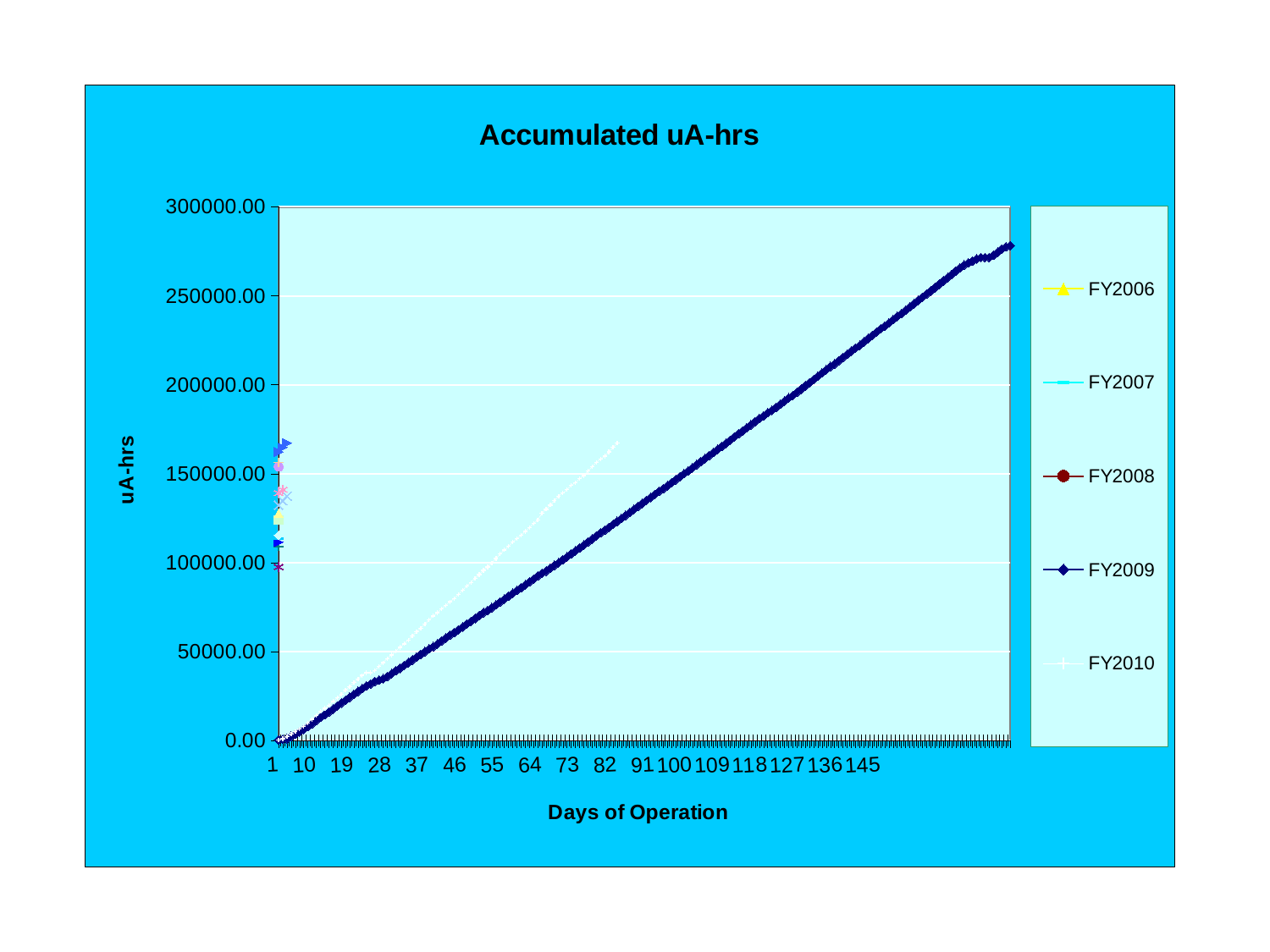
Is the highest value reached by the FY2010 series greater or less than 150000.00? greater Is the value of the FY2009 series at day 28 greater or less than 50000.00? less Does the FY2009 series rise or fall as the days of operation increase? rise What is the label of the x axis? Days of Operation Does the FY2010 series rise or fall along the x axis? rise What type of chart is shown on the slide? line chart Is the highest value reached by the FY2009 series greater or less than 300000.00? less What is the title of the chart? Accumulated uA-hrs How many series does the legend list? 5 Which series reaches the highest accumulated uA-hrs on the chart, FY2009 or FY2010? FY2009